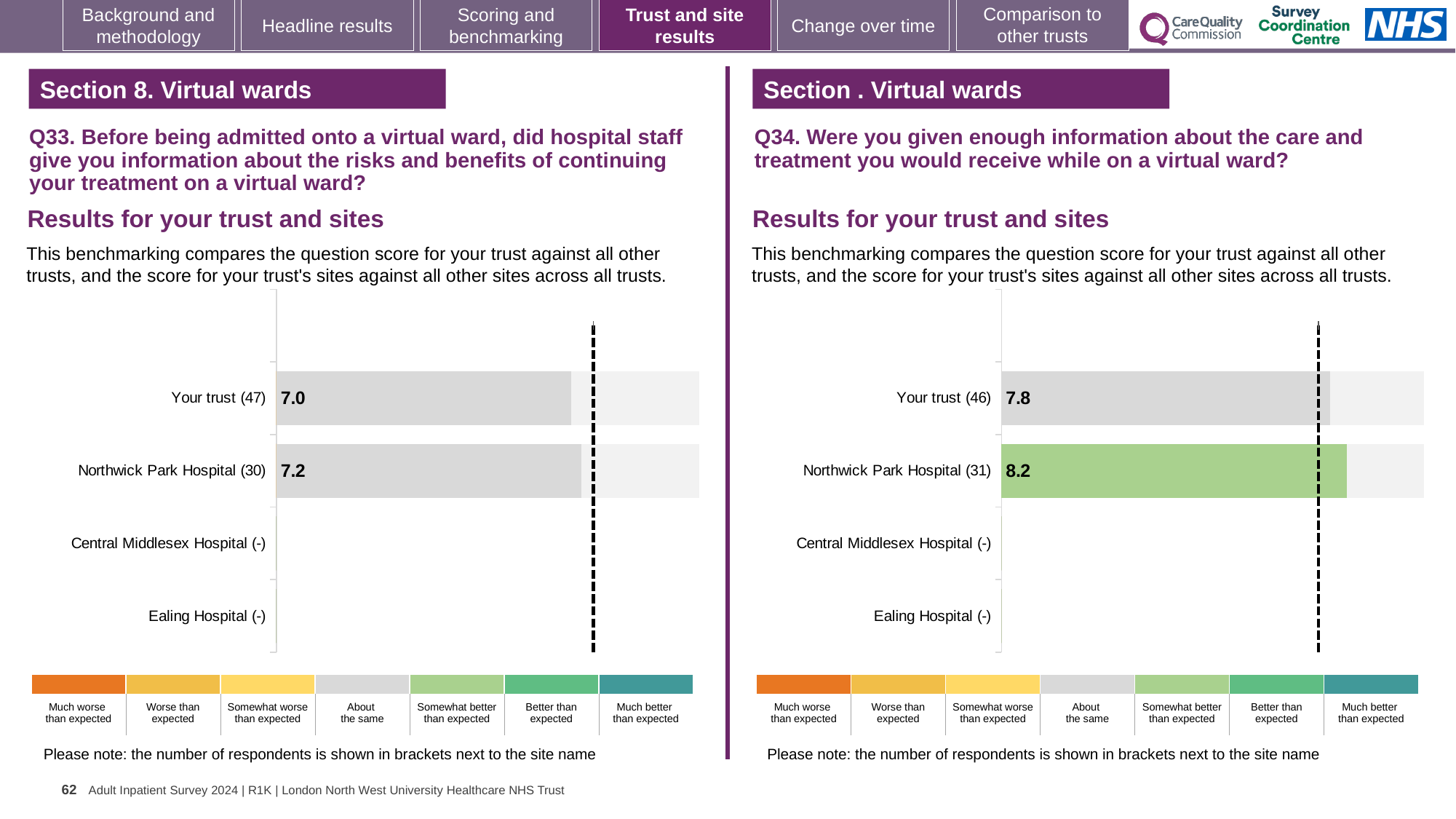
In the Q34 chart on the right, what is the score for Northwick Park Hospital? 8.2 In the Q34 chart on the right, how many respondents are shown in brackets for Northwick Park Hospital? 31 How many site/trust categories are listed on the y axis of the Q33 chart on the left? 4 In the Q34 chart on the right, which is higher: the score for Your trust or for Northwick Park Hospital? Northwick Park Hospital In the Q33 chart on the left, what is the score for Your trust? 7.0 In the Q33 chart on the left, what is the difference between the Northwick Park Hospital score and the Your trust score? 0.2 What kind of chart is used for the Q34 results on the right? Bar chart In the Q33 chart on the left, what is the score for Northwick Park Hospital? 7.2 In the Q34 chart on the right, which benchmark category does the green colour of the Northwick Park Hospital bar correspond to in the legend? Somewhat better than expected In the Q34 chart on the right, what is the score for Your trust? 7.8 In the Q33 chart on the left, how many respondents are shown in brackets for Your trust? 47 In the Q34 chart on the right, what is the difference between the Northwick Park Hospital score and the Your trust score? 0.4